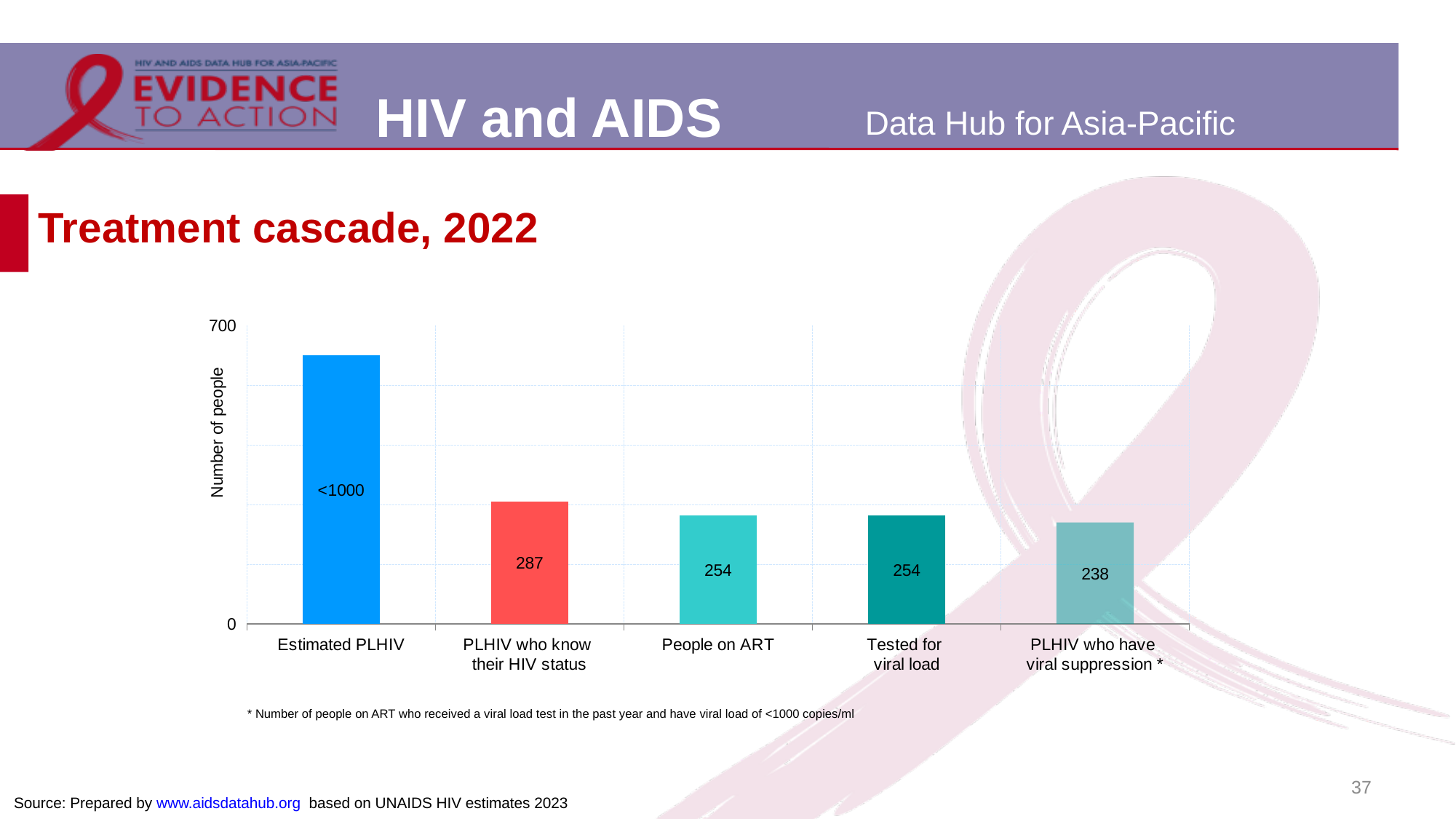
Do the values rise or fall from left to right across the categories? fall What value is shown for People on ART? 254 What is the difference between PLHIV who know their HIV status and People on ART? 33 What value is shown for PLHIV who know their HIV status? 287 What is the difference between Tested for viral load and PLHIV who have viral suppression? 16 Which category has the lowest value? PLHIV who have viral suppression Which category has the tallest bar? Estimated PLHIV What value is shown for PLHIV who have viral suppression? 238 Which is larger, PLHIV who know their HIV status or PLHIV who have viral suppression? PLHIV who know their HIV status How many categories are shown on the x axis? 5 What label is printed on the Estimated PLHIV bar? <1000 Is the value for Estimated PLHIV greater or less than 700? less